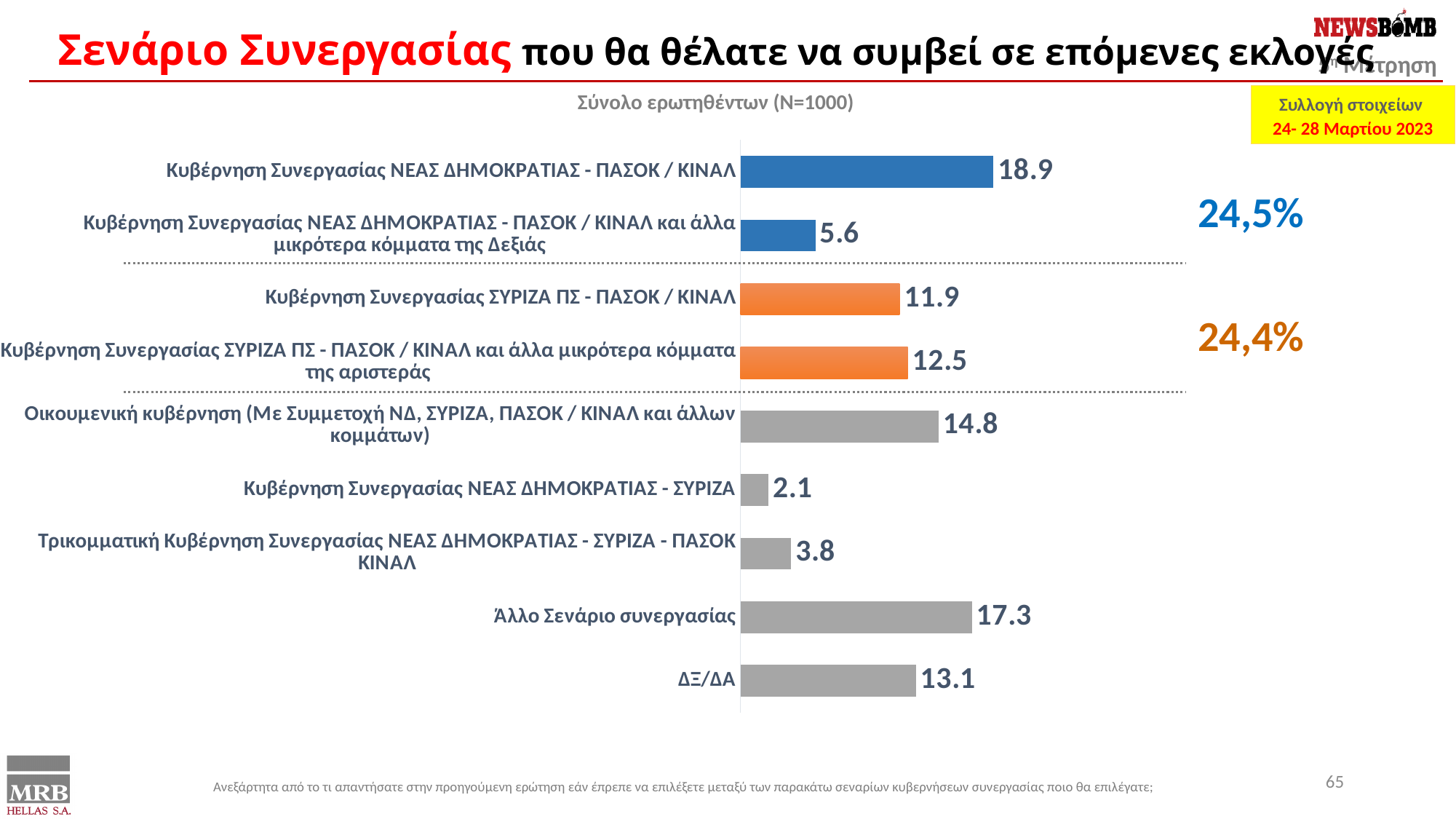
Which category has the lowest value? Κυβέρνηση Συνεργασίας ΝΕΑΣ ΔΗΜΟΚΡΑΤΙΑΣ - ΣΥΡΙΖΑ What combined percentage is shown next to the two blue bars? 24,5% What kind of chart is shown on the slide? Bar chart What is the value for "Οικουμενική κυβέρνηση (Με Συμμετοχή ΝΔ, ΣΥΡΙΖΑ, ΠΑΣΟΚ / ΚΙΝΑΛ και άλλων κομμάτων)"? 14.8 What combined percentage is shown next to the two orange bars? 24,4% Which is larger: the value for "Κυβέρνηση Συνεργασίας ΣΥΡΙΖΑ ΠΣ - ΠΑΣΟΚ / ΚΙΝΑΛ" or for "Κυβέρνηση Συνεργασίας ΣΥΡΙΖΑ ΠΣ - ΠΑΣΟΚ / ΚΙΝΑΛ και άλλα μικρότερα κόμματα της αριστεράς"? Κυβέρνηση Συνεργασίας ΣΥΡΙΖΑ ΠΣ - ΠΑΣΟΚ / ΚΙΝΑΛ και άλλα μικρότερα κόμματα της αριστεράς What is the difference between the values for "Κυβέρνηση Συνεργασίας ΝΕΑΣ ΔΗΜΟΚΡΑΤΙΑΣ - ΠΑΣΟΚ / ΚΙΝΑΛ" and "Άλλο Σενάριο συνεργασίας"? 1.6 How many categories are shown in the chart? 9 What is the value for "Κυβέρνηση Συνεργασίας ΝΕΑΣ ΔΗΜΟΚΡΑΤΙΑΣ - ΠΑΣΟΚ / ΚΙΝΑΛ"? 18.9 What is the value for "ΔΞ/ΔΑ"? 13.1 Which category has the highest value? Κυβέρνηση Συνεργασίας ΝΕΑΣ ΔΗΜΟΚΡΑΤΙΑΣ - ΠΑΣΟΚ / ΚΙΝΑΛ What is the value for "Άλλο Σενάριο συνεργασίας"? 17.3